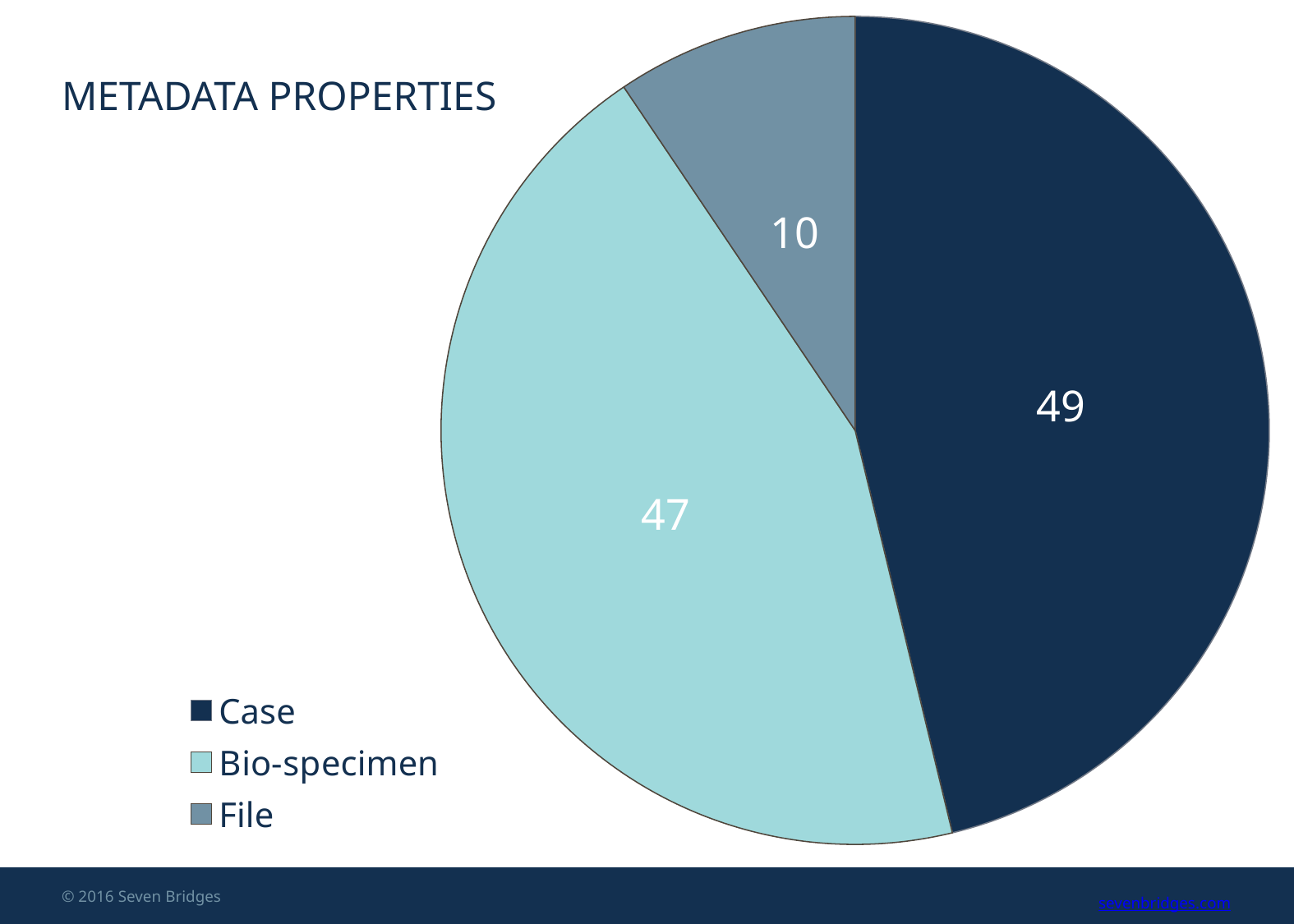
What is the difference between the values for Bio-specimen and File? 37 What is the value for Case? 49 Which category has the smallest slice? File Which category has the largest slice? Case What is the total of all slices in the pie chart? 106 What is the difference between the values for Case and Bio-specimen? 2 What kind of chart is shown on the slide? Pie chart How many categories does the pie chart show? 3 What is the value for File? 10 What is the title of the chart? METADATA PROPERTIES Which is larger, the value for Case or the value for Bio-specimen? Case What is the value for Bio-specimen? 47